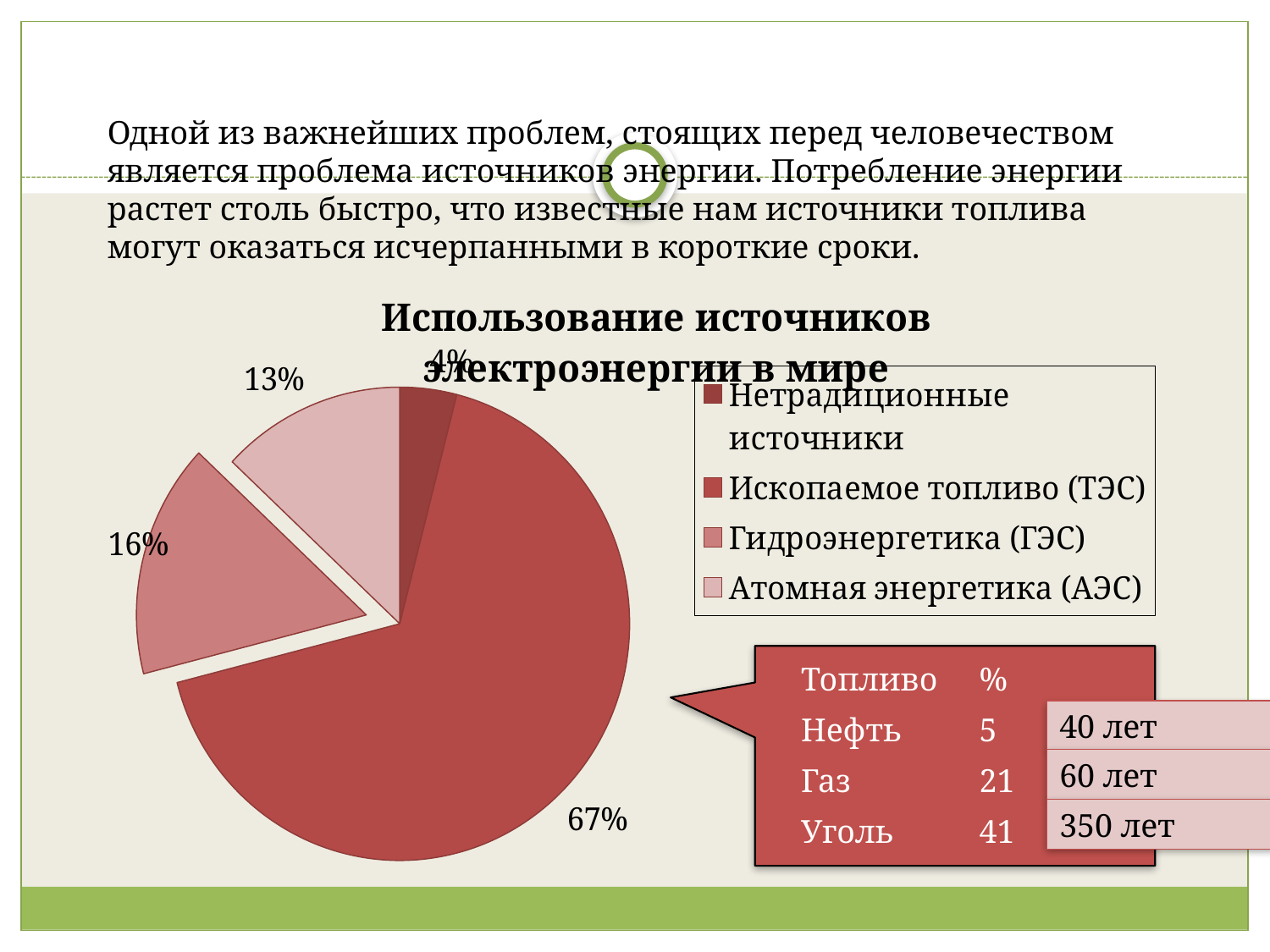
What share of the pie is Гидроэнергетика (ГЭС)? 16% Which slice of the pie is pulled out from the rest? Гидроэнергетика (ГЭС) What share of the pie is Атомная энергетика (АЭС)? 13% Which category has the smallest slice of the pie? Нетрадиционные источники What kind of chart is shown on the slide? pie chart Which category has the largest slice of the pie? Ископаемое топливо (ТЭС) Which is larger, the share for Гидроэнергетика (ГЭС) or for Атомная энергетика (АЭС)? Гидроэнергетика (ГЭС) What is the difference between the shares for Ископаемое топливо (ТЭС) and Гидроэнергетика (ГЭС)? 51% How many entries does the legend list? 4 How many slices does the pie chart have? 4 What share of the pie is Ископаемое топливо (ТЭС)? 67% What is the title of the chart? Использование источников электроэнергии в мире